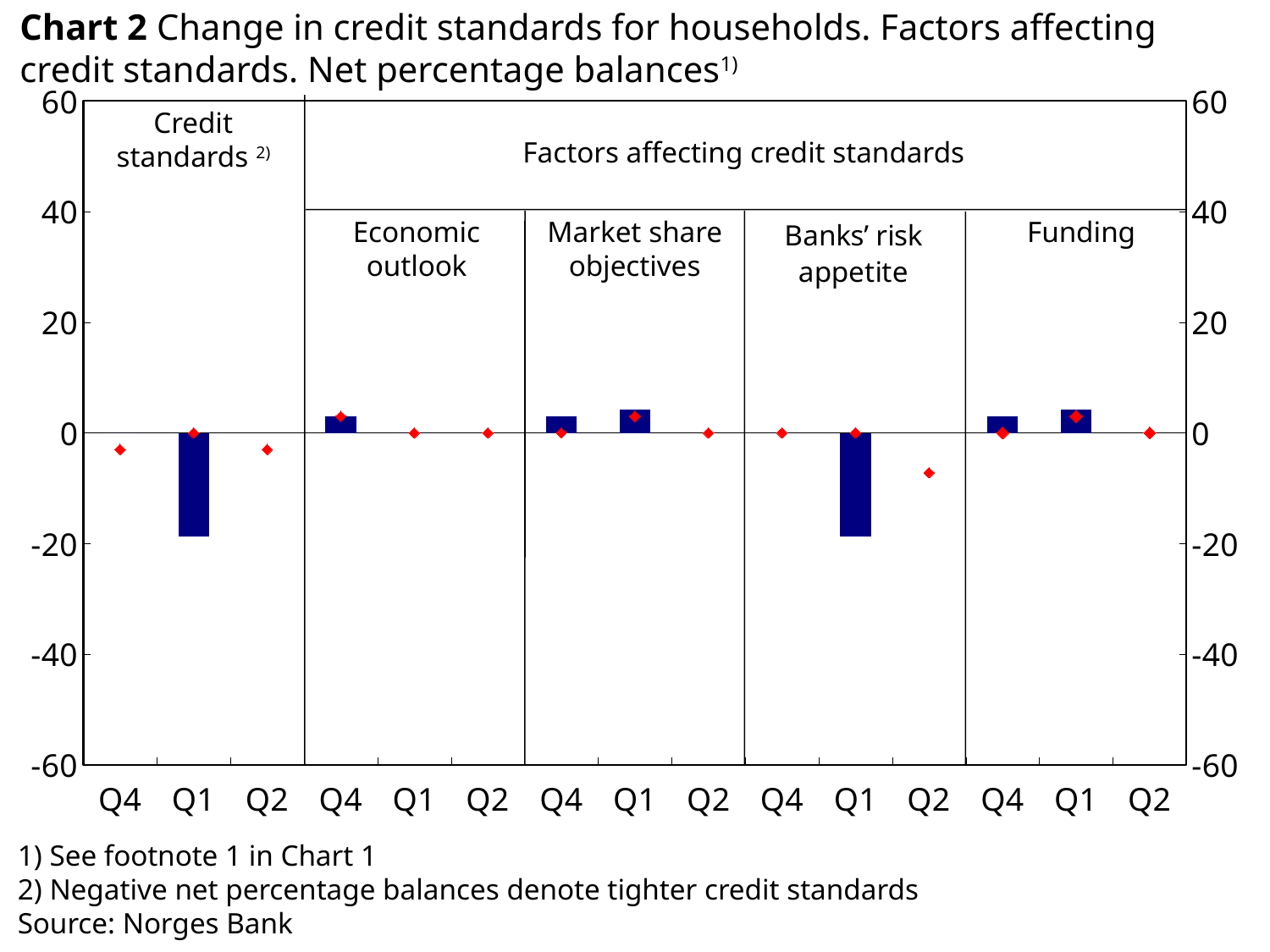
What is the source given for the chart? Norges Bank In the Banks' risk appetite panel, which quarter has the lowest bar? Q1 In the Banks' risk appetite panel, is the red diamond marker for Q2 greater or less than 0? less In the Credit standards panel, is the bar for Q1 greater or less than 0? less How many factor panels are shown under 'Factors affecting credit standards'? 4 In the Banks' risk appetite panel, is the bar for Q1 greater or less than 0? less What kind of chart is shown on the slide? bar chart What are the minimum and maximum values shown on the vertical axis? -60 and 60 How many quarters are labelled on the x axis within each panel? 3 Which is larger: the Q1 bar in the Banks' risk appetite panel or the Q4 bar in the Economic outlook panel? Q4 bar in Economic outlook